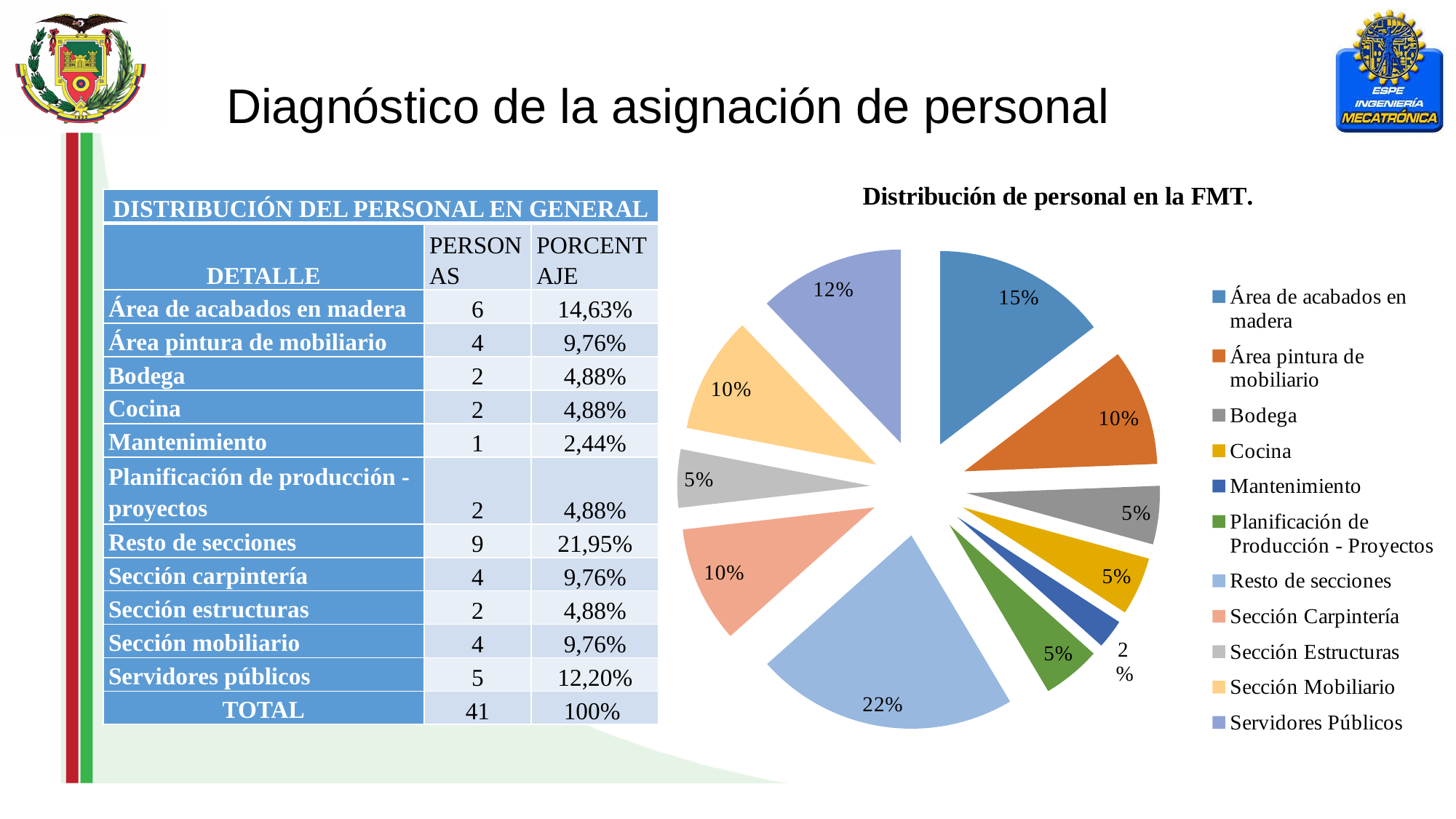
Which category has the smallest slice in the pie chart? Mantenimiento Which category has the largest slice in the pie chart? Resto de secciones What is the title of the pie chart? Distribución de personal en la FMT. What percentage does the pie chart show for Resto de secciones? 22% In the pie chart, how many percentage points larger is Resto de secciones than Área de acabados en madera? 7 What percentage does the pie chart show for Servidores Públicos? 12% What kind of chart is shown on the slide? pie chart In the pie chart, which is larger: Servidores Públicos or Área pintura de mobiliario? Servidores Públicos What percentage does the pie chart show for Área de acabados en madera? 15% How many slices does the pie chart have? 11 What colour is the Resto de secciones slice in the pie chart? light blue What percentage does the pie chart show for Mantenimiento? 2%